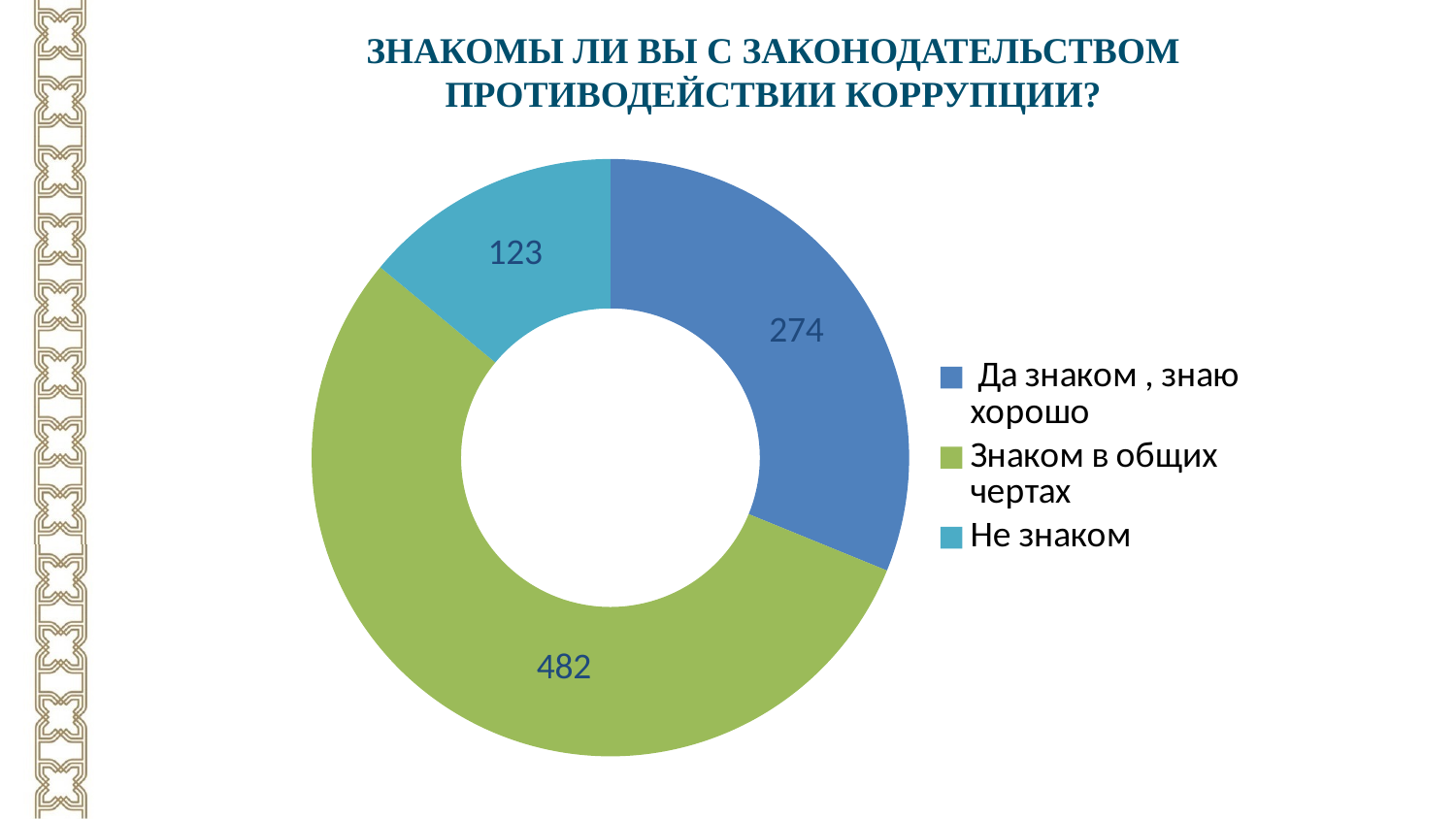
What value is shown for the category "Знаком в общих чертах"? 482 Which is larger: the value for "Да знаком, знаю хорошо" or the value for "Не знаком"? Да знаком, знаю хорошо How many categories does the chart show? 3 What value is shown for the category "Не знаком"? 123 Which category has the lowest value? Не знаком What kind of chart is shown on the slide? doughnut chart What value is shown for the category "Да знаком, знаю хорошо"? 274 What is the difference between the values for "Знаком в общих чертах" and "Да знаком, знаю хорошо"? 208 What is the difference between the values for "Да знаком, знаю хорошо" and "Не знаком"? 151 Which category has the highest value? Знаком в общих чертах What is the total of all three values in the chart? 879 What colour is the slice for "Не знаком"? teal (light blue)